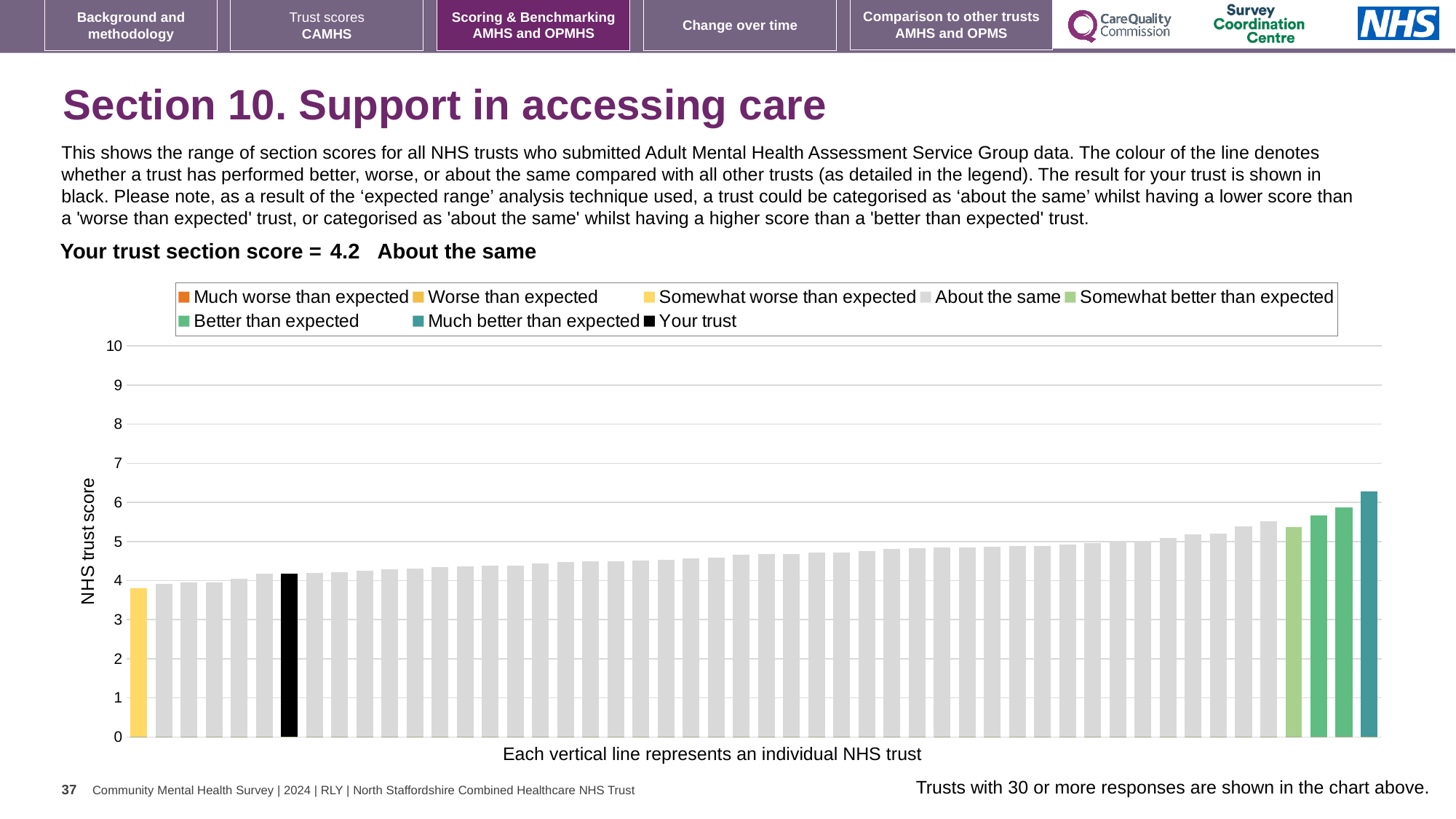
Is the value for your trust greater or less than 4? greater Is the value of the leftmost bar greater or less than 4? less Which legend category does the tallest bar belong to? Much better than expected Do the bar values rise or fall from left to right across the chart? rise What is the label on the vertical axis of the chart? NHS trust score How is your trust categorised compared with other trusts in this section? About the same How many entries does the chart legend list? 8 Is the value of the tallest bar (rightmost) greater or less than 6? greater What colour is the bar representing your trust? black What is your trust's section score for Section 10, Support in accessing care? 4.2 Which is larger, the leftmost bar or your trust's bar? your trust's bar What kind of chart is shown on the slide? bar chart